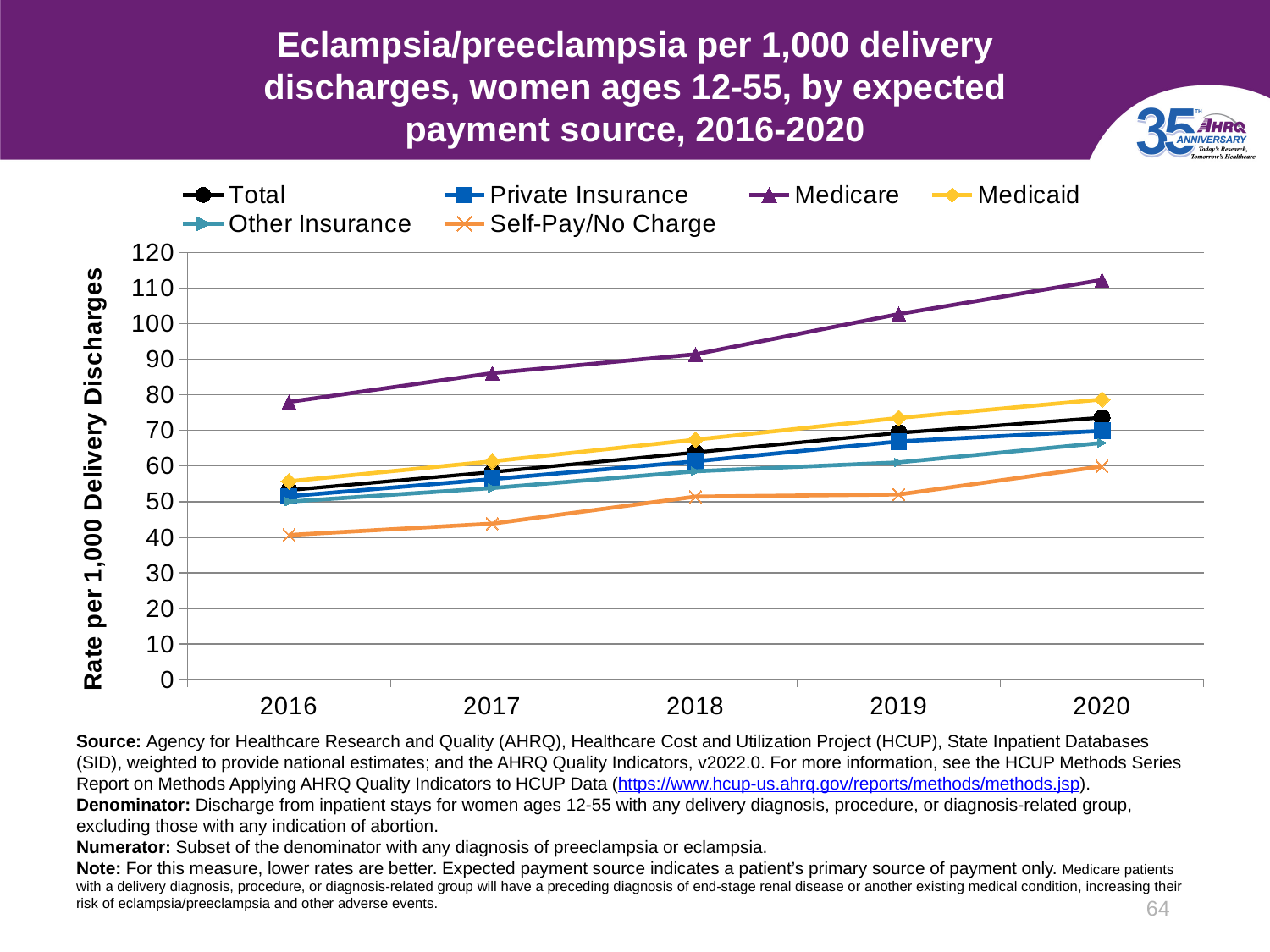
Does the Medicare rate rise or fall from 2016 to 2020? Rise Is the value for Medicare in 2016 greater or less than 70? greater How many series does the legend list? 6 Which payment source has the lowest rate in 2016? Self-Pay/No Charge What kind of chart is shown on the slide? Line chart How many years are plotted along the x axis? 5 Which payment source has the highest rate in 2020? Medicare Which is larger in 2020, the rate for Medicaid or for Private Insurance? Medicaid Is the value for Medicare in 2020 greater or less than 100? greater Does the Self-Pay/No Charge rate rise or fall from 2016 to 2020? Rise What is the title of the y axis? Rate per 1,000 Delivery Discharges Is the value for Self-Pay/No Charge in 2016 greater or less than 50? less